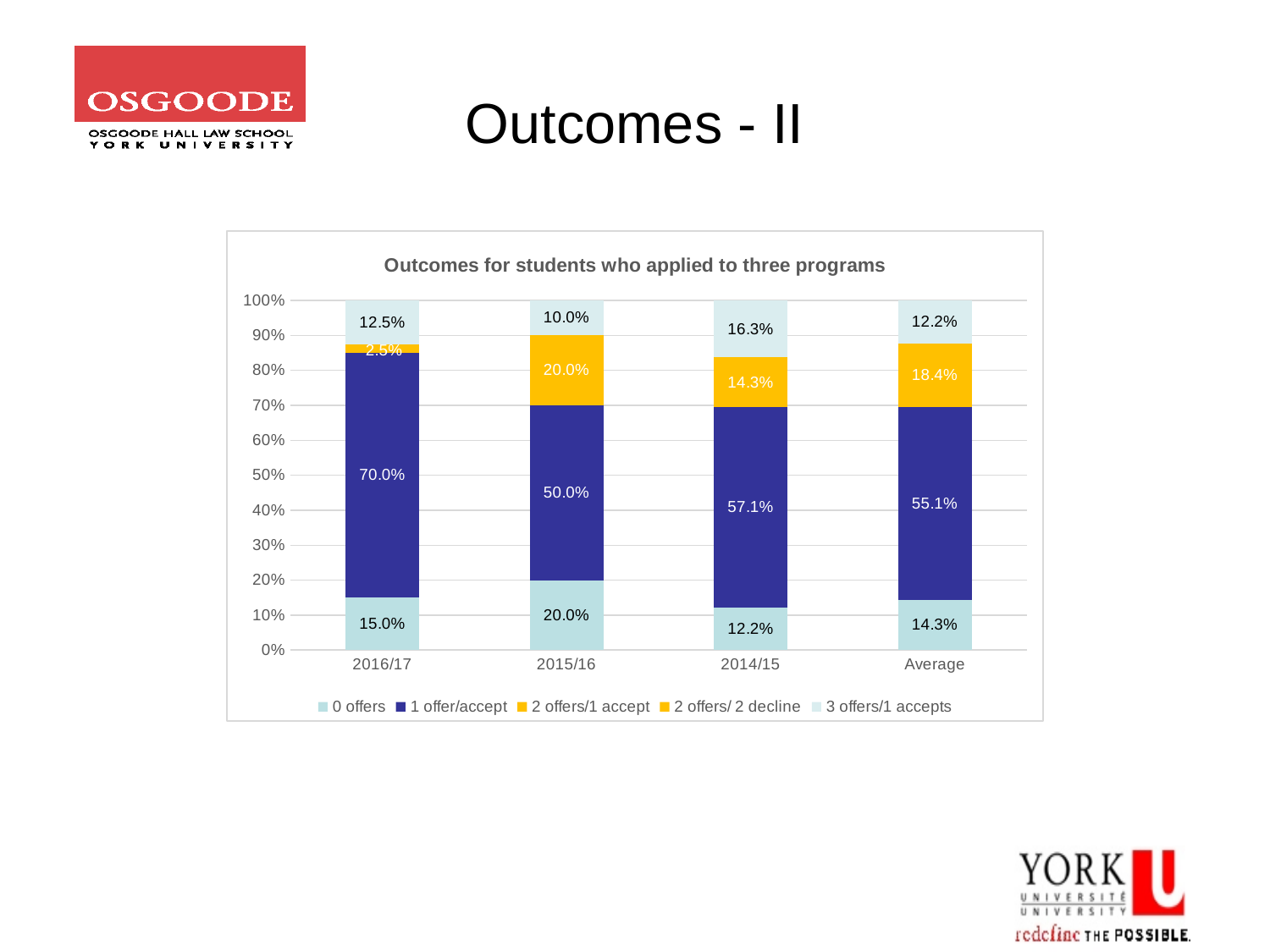
Which category has the highest value for 1 offer/accept? 2016/17 What is the title of the chart? Outcomes for students who applied to three programs What is the value for 1 offer/accept in the Average bar? 55.1% How many categories are shown on the x axis? 4 What is the value for 0 offers in 2015/16? 20.0% What is the difference between the 1 offer/accept values for 2016/17 and 2015/16? 20.0% What is the value for 0 offers in 2014/15? 12.2% Which category has the lowest value for 0 offers? 2014/15 What is the value for 1 offer/accept in 2016/17? 70.0% What kind of chart is shown on the slide? Stacked bar chart How many series does the legend list? 5 Which is larger, the 0 offers value for 2016/17 or for 2015/16? 2015/16